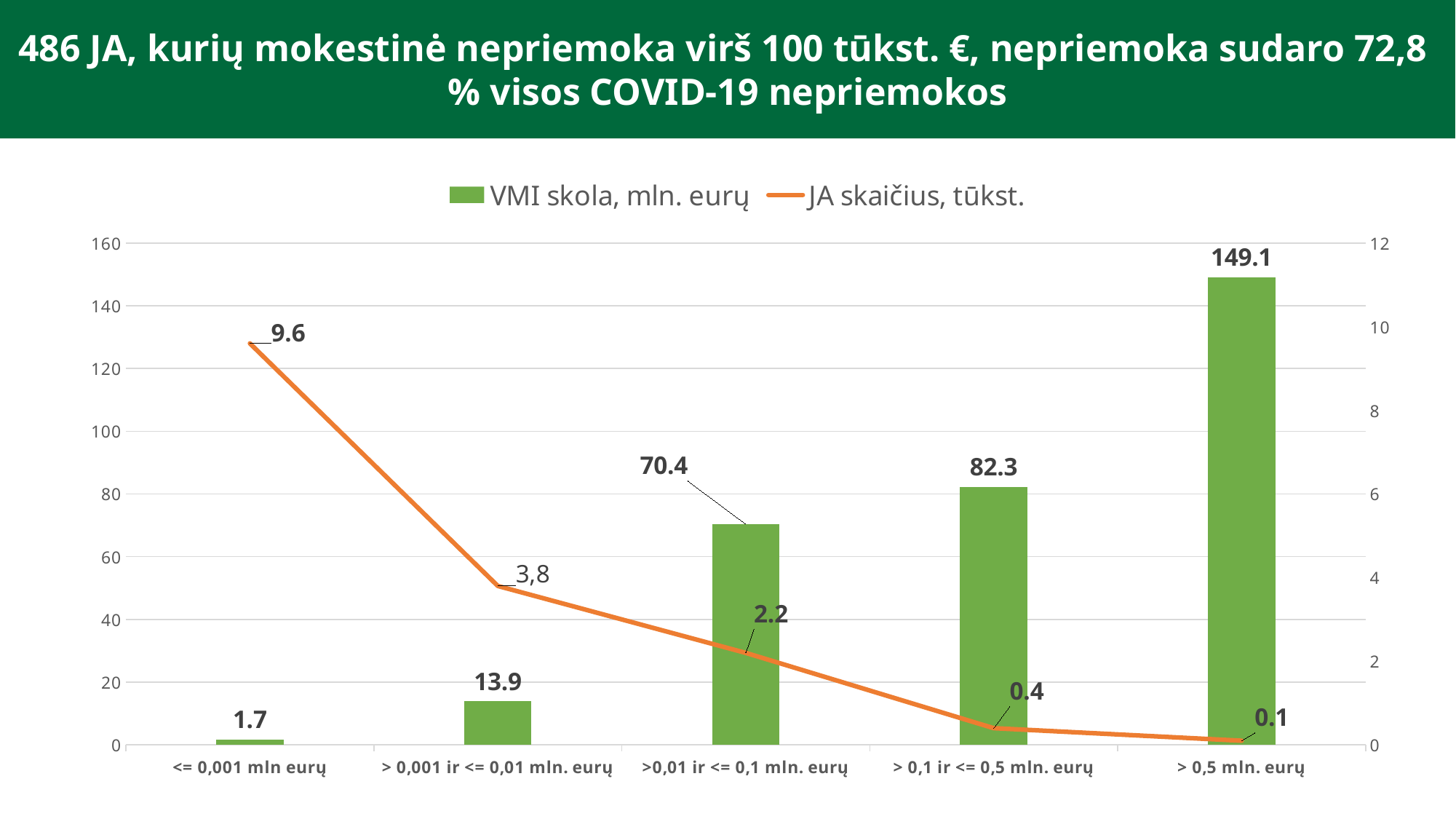
What is the VMI skola, mln. eurų value for the category ">0,01 ir <= 0,1 mln. eurų"? 70.4 Which is larger, the VMI skola, mln. eurų value for "> 0,001 ir <= 0,01 mln. eurų" or for "<= 0,001 mln eurų"? > 0,001 ir <= 0,01 mln. eurų What is the JA skaičius, tūkst. value for the category "<= 0,001 mln eurų"? 9.6 Which category has the lowest JA skaičius, tūkst. value? > 0,5 mln. eurų What is the JA skaičius, tūkst. value for the category "> 0,001 ir <= 0,01 mln. eurų"? 3,8 What is the difference between the VMI skola, mln. eurų values for "> 0,1 ir <= 0,5 mln. eurų" and ">0,01 ir <= 0,1 mln. eurų"? 11.9 How many series does the legend list? 2 Does the JA skaičius, tūkst. line rise or fall from left to right across the categories? fall What is the VMI skola, mln. eurų value for the category "> 0,5 mln. eurų"? 149.1 What colour are the VMI skola, mln. eurų bars? green Which category has the highest VMI skola, mln. eurų value? > 0,5 mln. eurų How many categories are shown on the x axis? 5